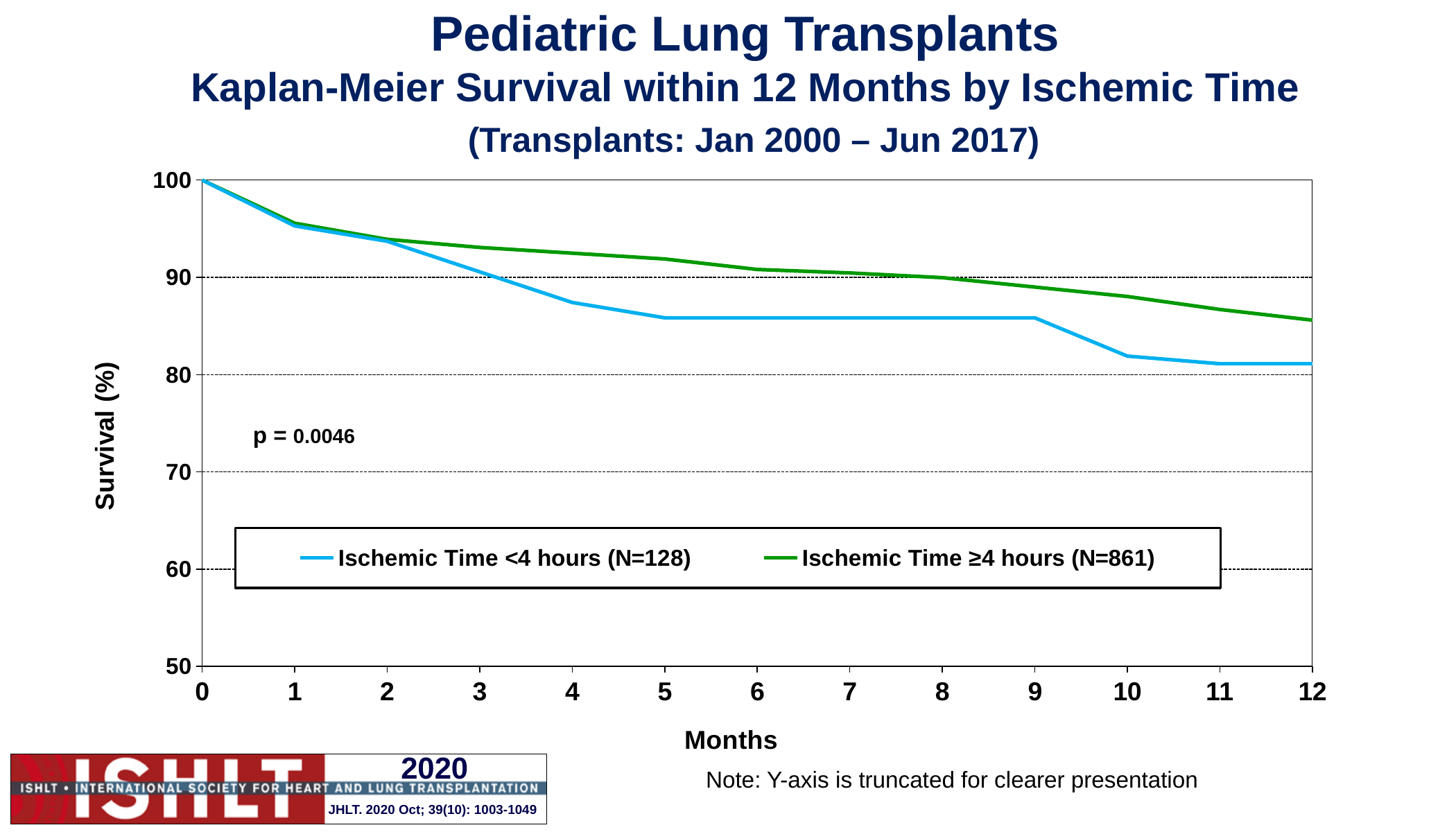
Is the survival value for Ischemic Time ≥4 hours at 12 months greater or less than 90? less Is the survival value for Ischemic Time ≥4 hours at 3 months greater or less than 90? greater How many series does the legend list? 2 What p-value is shown on the chart? p = 0.0046 Is the survival value for Ischemic Time <4 hours at 5 months greater or less than 90? less At 12 months, which series has the higher survival: Ischemic Time <4 hours or Ischemic Time ≥4 hours? Ischemic Time ≥4 hours At 6 months, which series has the higher survival: Ischemic Time <4 hours or Ischemic Time ≥4 hours? Ischemic Time ≥4 hours What kind of chart is shown on the slide? line chart What is the N for the Ischemic Time <4 hours group in the legend? N=128 What is the survival value for both series at month 0? 100 Do the survival values rise or fall as months increase along the x axis? fall